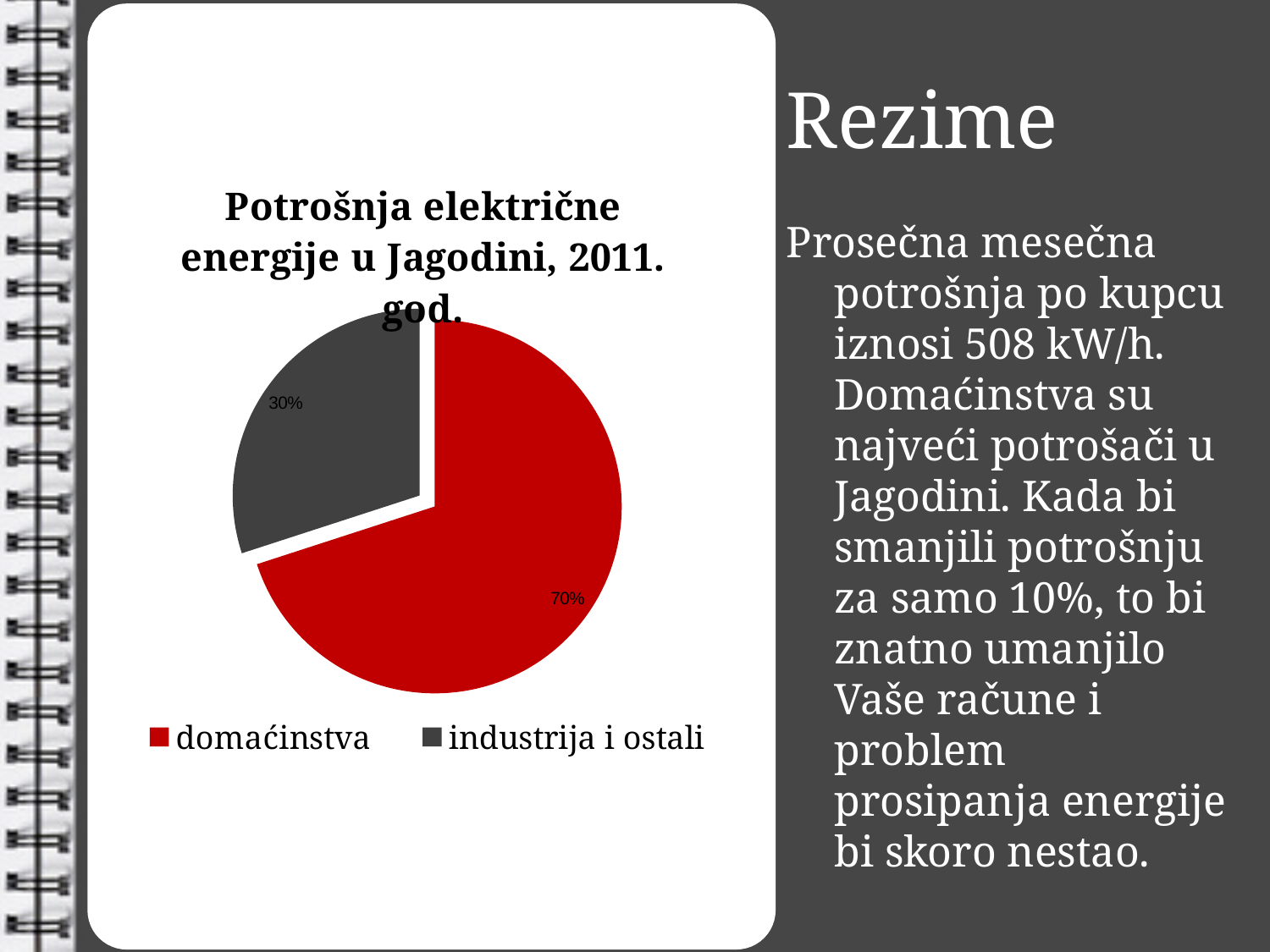
What kind of chart is shown on the slide? pie chart What colour is the slice for domaćinstva? red Is the share for industrija i ostali greater or less than 50%? less What share of the pie does domaćinstva account for? 70% Which category has the smallest slice of the pie? industrija i ostali Which is larger, the slice for domaćinstva or the slice for industrija i ostali? domaćinstva How many categories are shown in the pie chart? 2 What is the title of the chart? Potrošnja električne energije u Jagodini, 2011. god. What share of the pie does industrija i ostali account for? 30% What is the difference in percentage points between the domaćinstva slice and the industrija i ostali slice? 40 Which category has the largest slice of the pie? domaćinstva